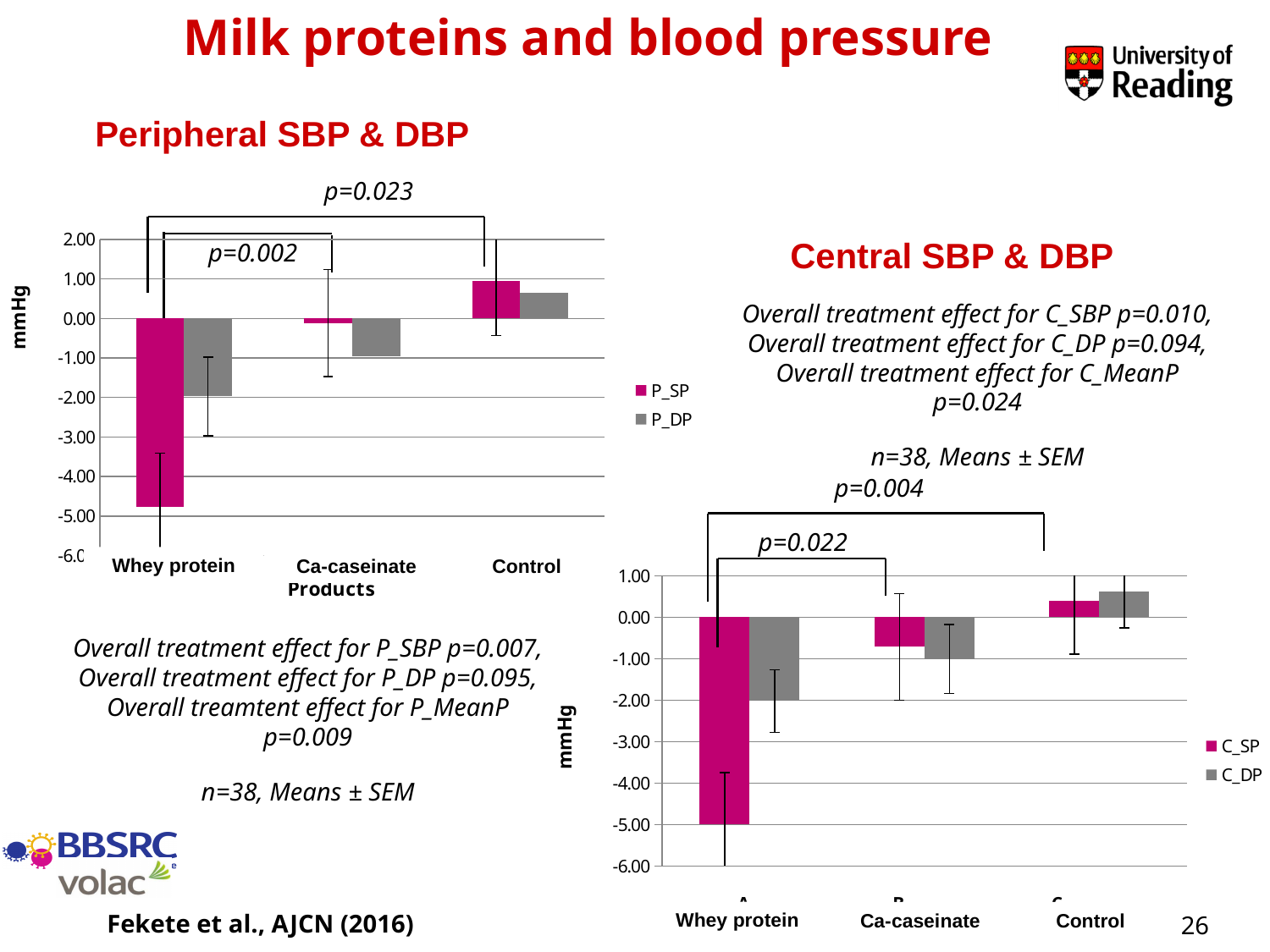
In the Peripheral SBP & DBP chart, is the P_SP value for Whey protein greater or less than -4.00? less In the Central SBP & DBP chart, is the C_SP value for Whey protein greater or less than -4.00? less How many categories are shown on the x axis of the Peripheral SBP & DBP chart? 3 What are the legend entries of the Central SBP & DBP chart? C_SP and C_DP In the Peripheral SBP & DBP chart, which category has the highest P_SP value? Control What is the y-axis label of the Central SBP & DBP chart? mmHg In the Peripheral SBP & DBP chart, for Whey protein, which is lower: P_SP or P_DP? P_SP What kind of chart is the Peripheral SBP & DBP chart? bar chart In the Central SBP & DBP chart, which category has the highest C_DP value? Control In the Central SBP & DBP chart, is the C_DP value for Ca-caseinate greater or less than 0.00? less How many series does the legend of the Peripheral SBP & DBP chart list? 2 In the Peripheral SBP & DBP chart, which category has the lowest P_SP value? Whey protein